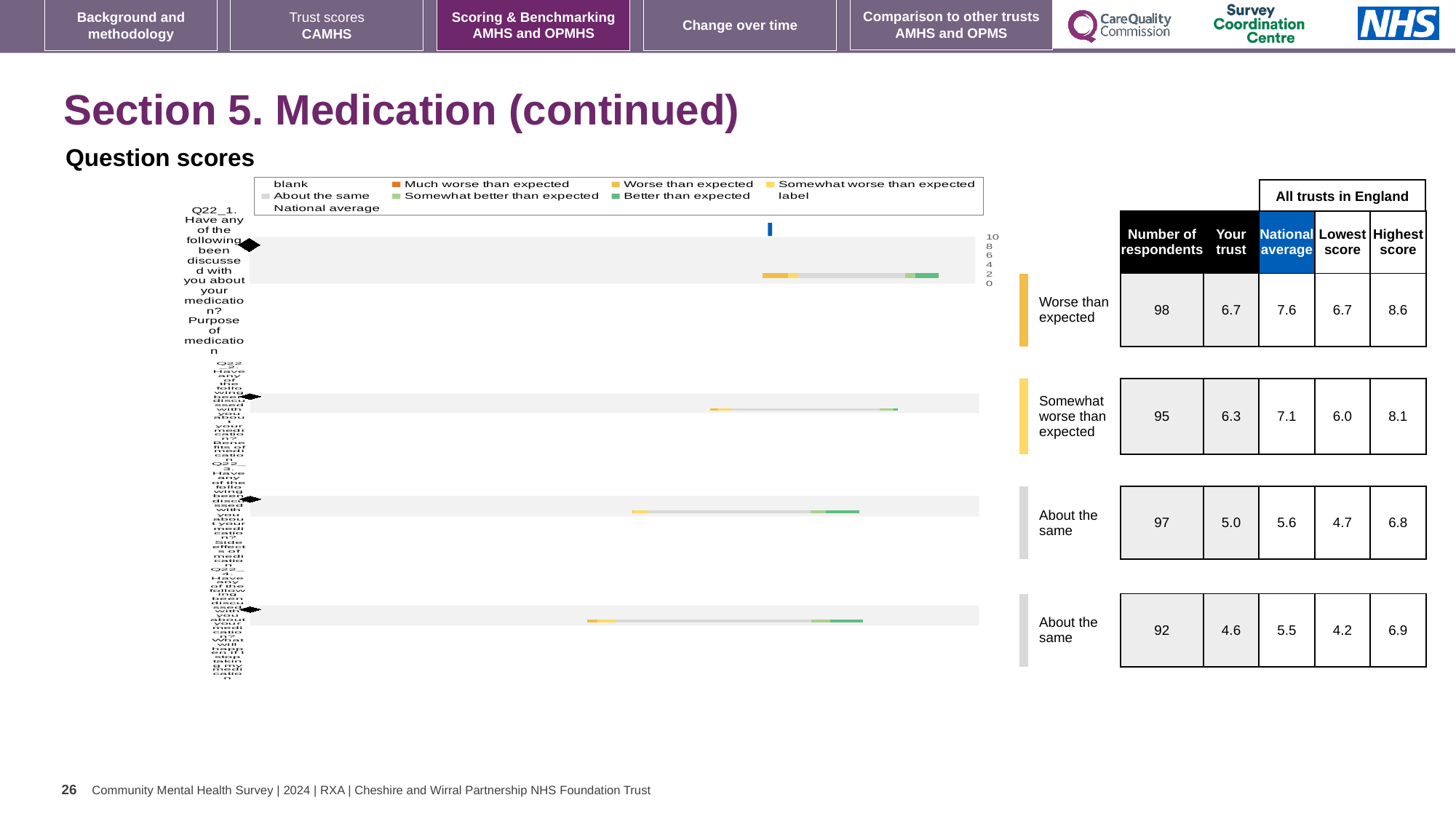
In the table, what is the lowest score for the row labelled 'Somewhat worse than expected'? 6.0 What kind of chart is shown under 'Question scores'? bar chart In the table, how many respondents are listed for the first row (Worse than expected)? 98 In the table, which row has the highest 'Highest score' value? Worse than expected (8.6) In the table, what is the 'Your trust' score for the row labelled 'Worse than expected'? 6.7 What colour does the legend use for 'Better than expected'? green In the table, what is the lowest 'Your trust' score across the four rows? 4.6 In the table, what is the difference between the national average and the 'Your trust' score for the 'Worse than expected' row? 0.9 In the table, which is larger for the 'Worse than expected' row: the 'Your trust' score or the national average? National average What is the highest value shown on the chart's axis? 10 In the table, what is the national average for the row labelled 'Somewhat worse than expected'? 7.1 How many question bars are plotted in the chart? 4